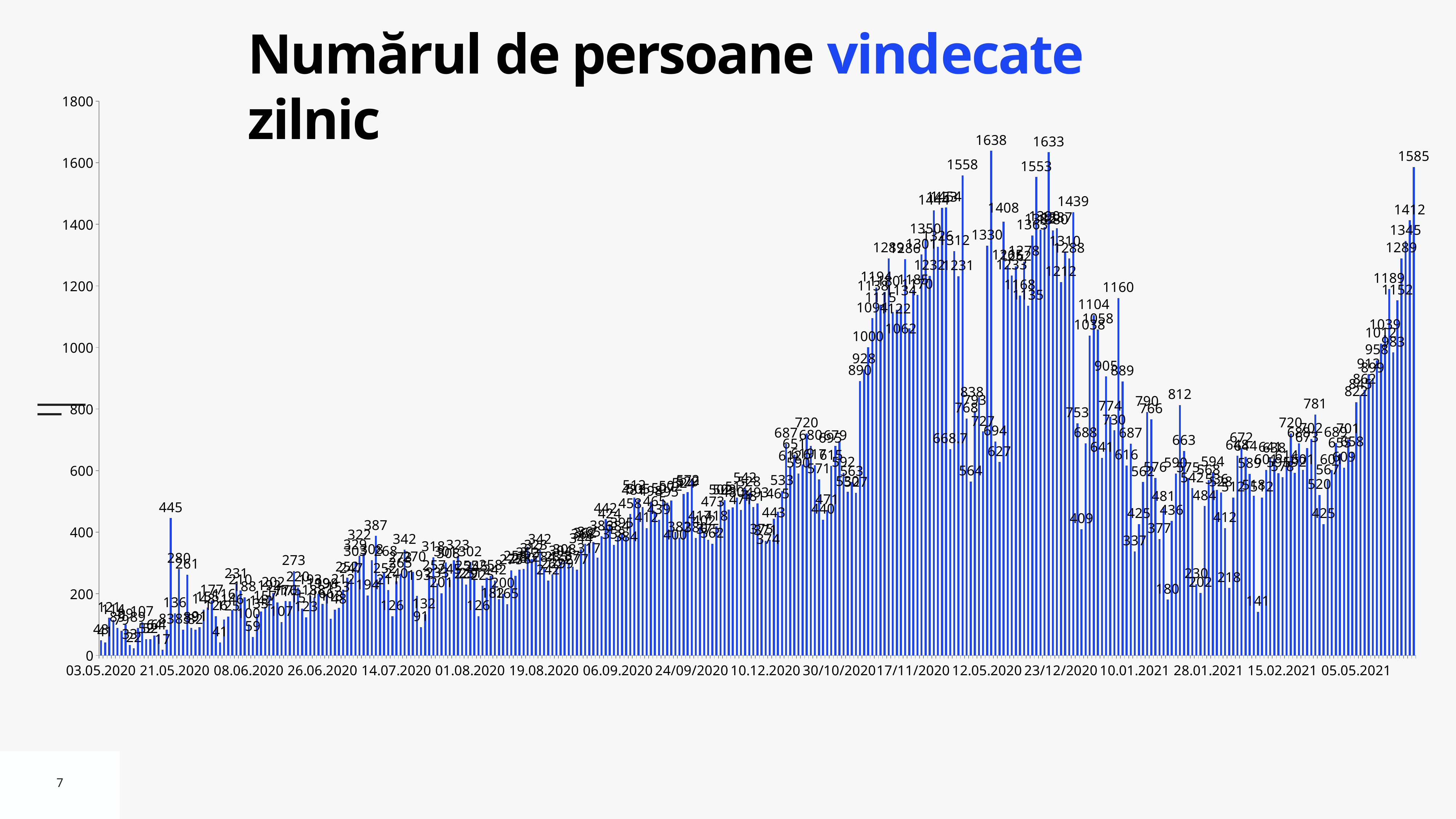
What is the last date label on the x axis? 05.05.2021 What is the first date label on the x axis? 03.05.2020 What is the difference between the highest labeled value (1638) and the value of the rightmost bar (1585)? 53 Is the highest bar on the chart greater or less than 1600? greater How many date labels are shown on the x axis? 18 What is the value of the last (rightmost) bar on the chart? 1585 Overall, do the values rise or fall from the start of the x axis to the end? rise What is the value of the tallest bar between the 03.05.2020 and 08.06.2020 axis labels? 445 What is the value of the tallest bar between the 10.01.2021 and 28.01.2021 axis labels? 812 What is the title of the chart? Numărul de persoane vindecate zilnic What is the highest value labeled on the chart? 1638 What kind of chart is shown on the slide? bar chart